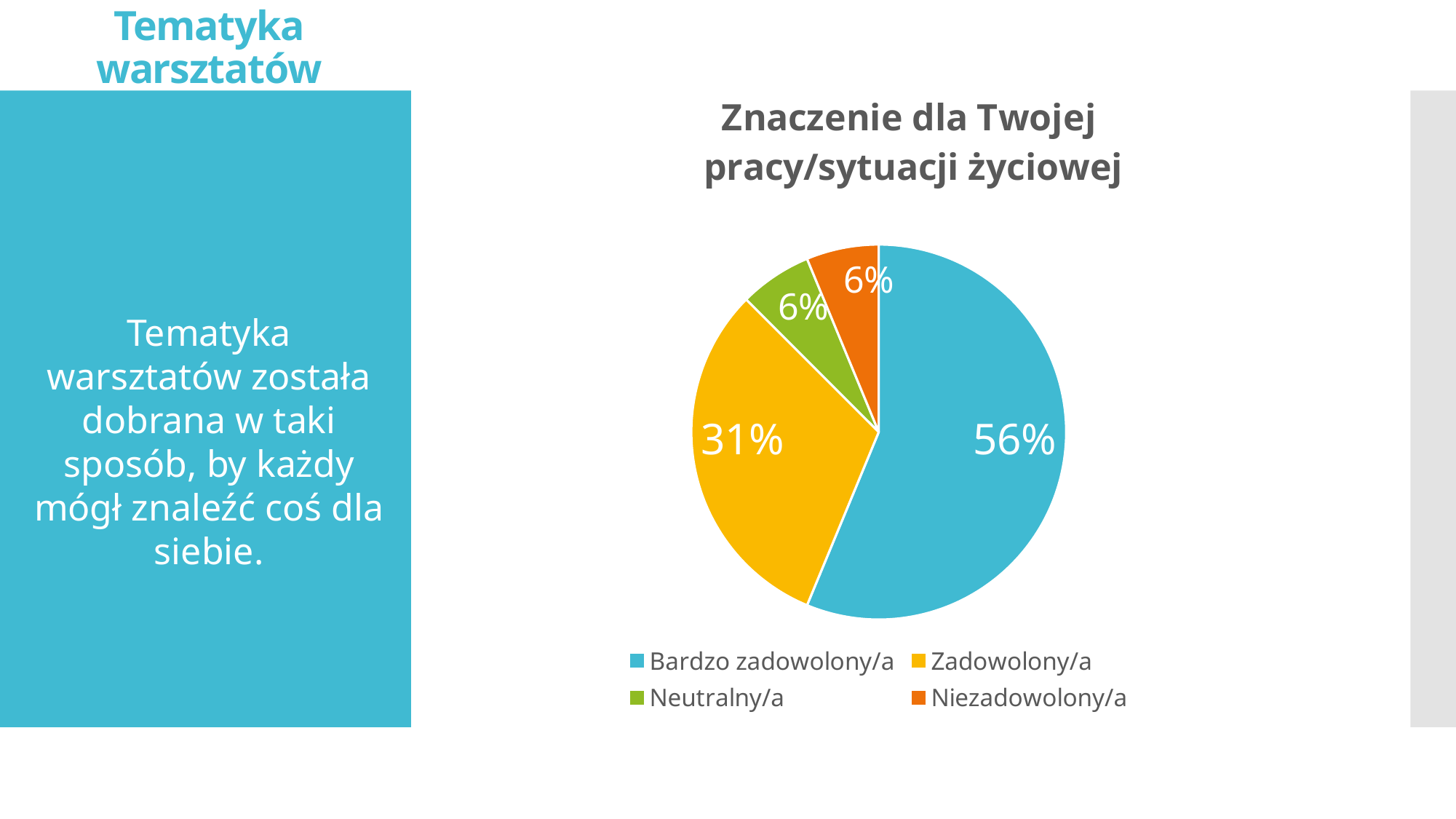
What share of the pie is labelled Niezadowolony/a? 6% What is the difference between the Bardzo zadowolony/a and Zadowolony/a shares? 25% What kind of chart is shown on the slide? pie chart What share of the pie is labelled Neutralny/a? 6% Which is larger, the Zadowolony/a slice or the Neutralny/a slice? Zadowolony/a What share of the pie is labelled Zadowolony/a? 31% Which category has the largest slice of the pie? Bardzo zadowolony/a Is the share for Bardzo zadowolony/a greater or less than 50%? greater What is the title of the chart? Znaczenie dla Twojej pracy/sytuacji życiowej What colour is the Niezadowolony/a slice? orange How many categories does the legend list? 4 What share of the pie is labelled Bardzo zadowolony/a? 56%